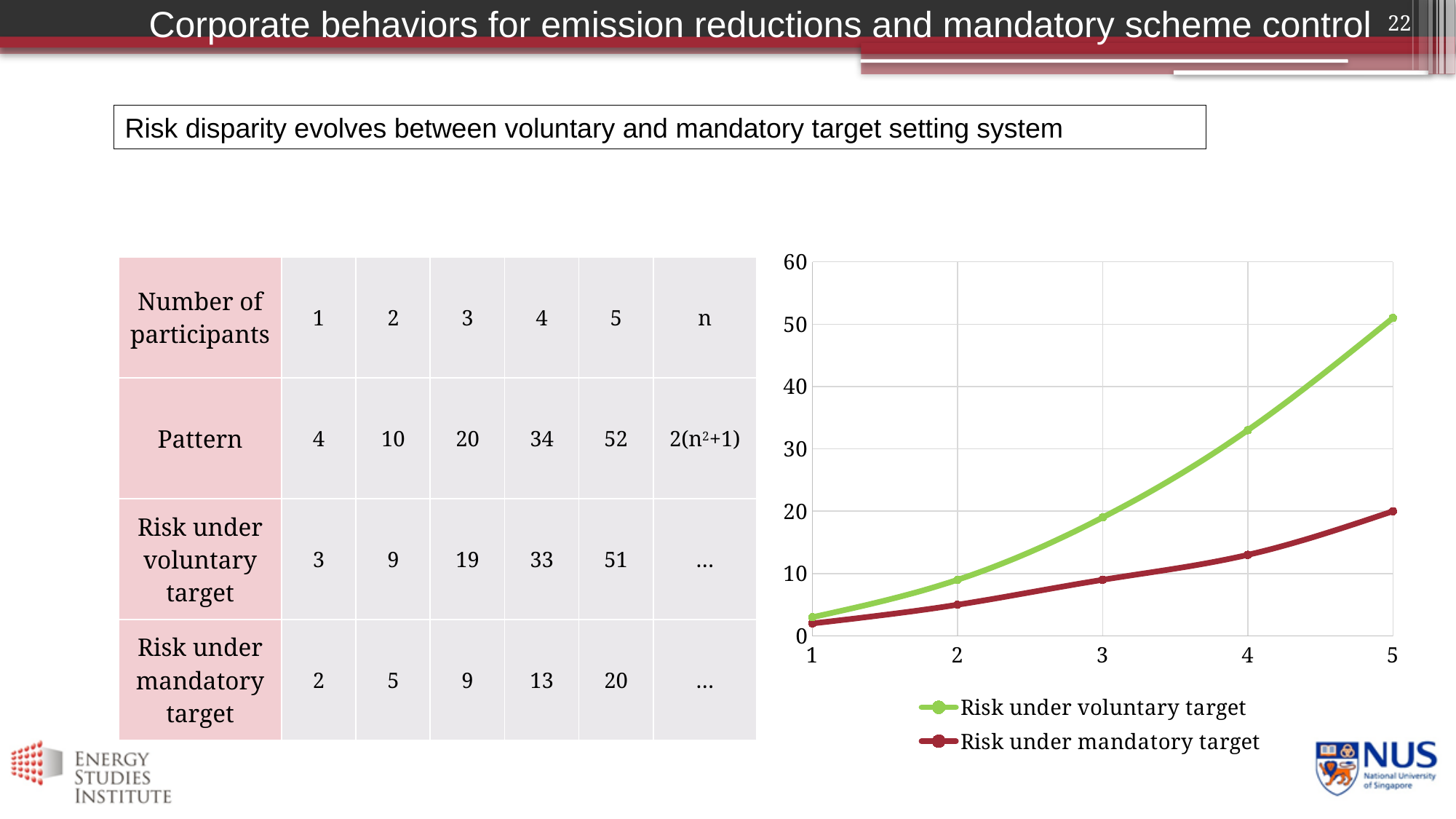
How many points along the x axis does each line in the chart have? 5 Do the values of Risk under voluntary target rise or fall as the number of participants increases from 1 to 5? rise Is the value of Risk under voluntary target at 4 participants greater or less than 30? greater At 5 participants, which series has the larger value, Risk under voluntary target or Risk under mandatory target? Risk under voluntary target What colour is the line for Risk under mandatory target? dark red What kind of chart is shown on the slide? line chart What is the value of Risk under voluntary target at 5 participants? 51 What is the difference between Risk under voluntary target and Risk under mandatory target at 5 participants? 31 What is the value of Risk under mandatory target at 5 participants? 20 What is the value of Risk under voluntary target at 3 participants? 19 Is the value of Risk under mandatory target at 4 participants greater or less than 20? less How many series does the chart legend list? 2